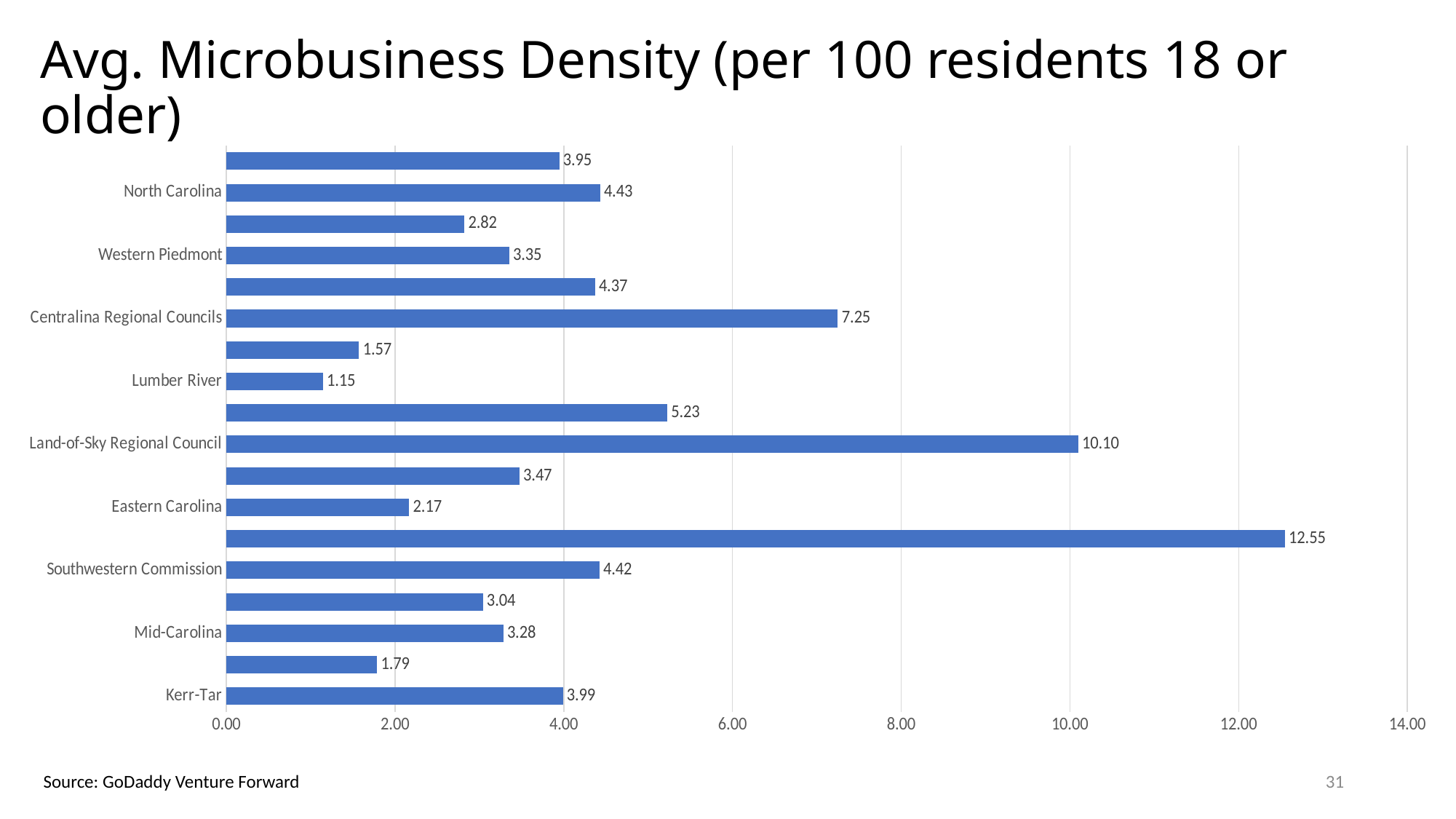
What is the value for Lumber River? 1.15 What is the value for Centralina Regional Councils? 7.25 How many bars are plotted in the chart? 18 What is the value for Land-of-Sky Regional Council? 10.10 What is the difference between the values for Land-of-Sky Regional Council and Centralina Regional Councils? 2.85 What is the value for Kerr-Tar? 3.99 What is the source cited for the chart? GoDaddy Venture Forward Which labeled category has the lowest value? Lumber River Is the value for Eastern Carolina greater or less than 4.00? less Which is larger, the value for North Carolina or the value for Western Piedmont? North Carolina What is the title of the chart? Avg. Microbusiness Density (per 100 residents 18 or older) What kind of chart is shown on the slide? bar chart